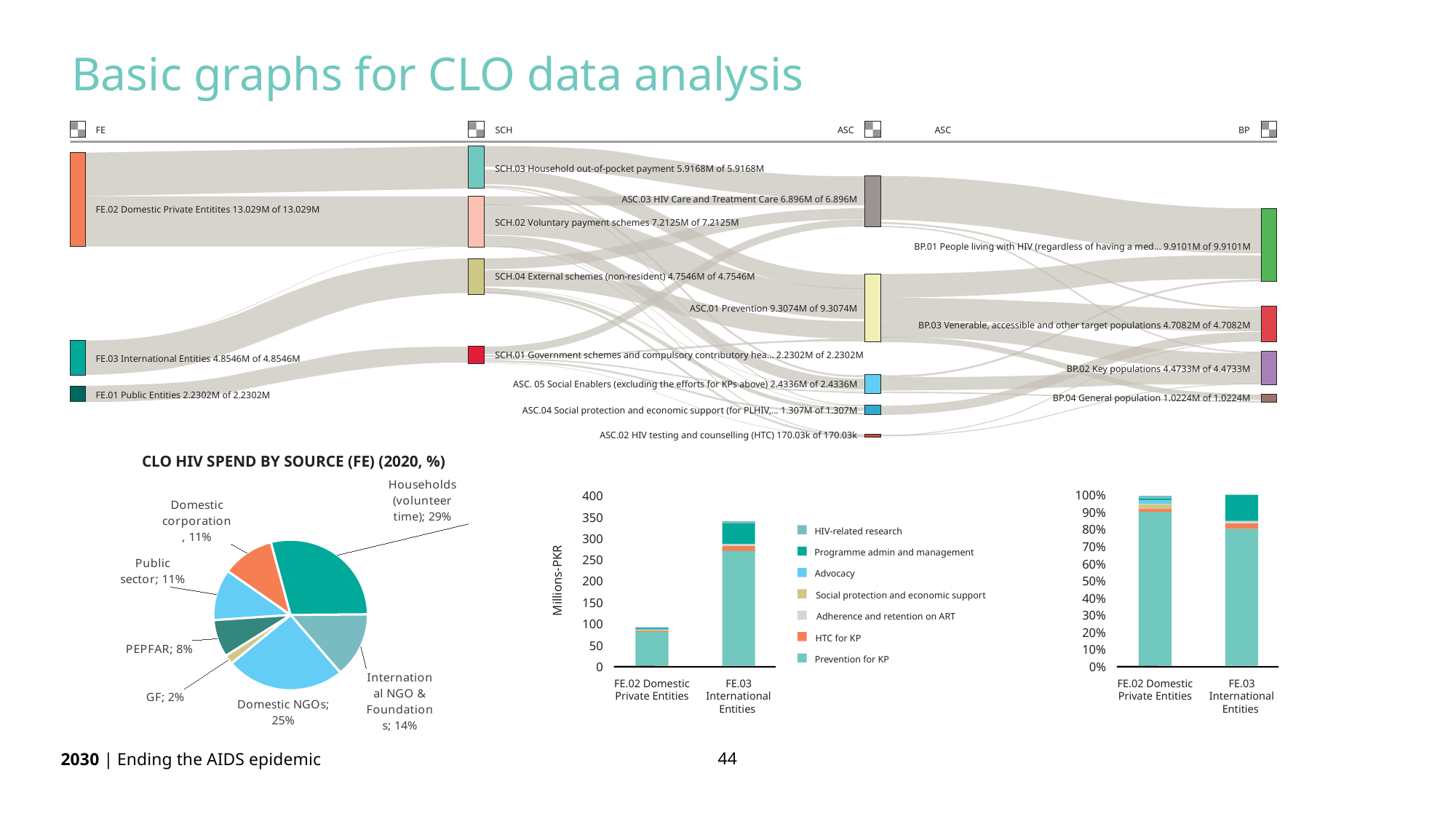
In the pie chart 'CLO HIV SPEND BY SOURCE (FE) (2020, %)', what share is attributed to Domestic NGOs? 25% In the middle stacked bar chart (Millions PKR), which category has the larger total, FE.02 Domestic Private Entities or FE.03 International Entities? FE.03 International Entities In the pie chart 'CLO HIV SPEND BY SOURCE (FE) (2020, %)', what is the difference between the Domestic NGOs share and the PEPFAR share? 17% In the pie chart 'CLO HIV SPEND BY SOURCE (FE) (2020, %)', what share is attributed to Households (volunteer time)? 29% In the pie chart 'CLO HIV SPEND BY SOURCE (FE) (2020, %)', which source has the largest share? Households (volunteer time) In the pie chart 'CLO HIV SPEND BY SOURCE (FE) (2020, %)', which source has the smallest share? GF In the flow diagram at the top of the slide, what value is shown for FE.02 Domestic Private Entitites? 13.029M What kind of chart is the chart at the bottom right of the slide? Bar chart (100% stacked) In the middle stacked bar chart (Millions PKR), how many series does the legend list? 7 In the middle stacked bar chart (Millions PKR), is the total for FE.03 International Entities greater or less than 300? greater In the middle stacked bar chart (Millions PKR), is the total for FE.02 Domestic Private Entities greater or less than 100? less How many slices does the pie chart 'CLO HIV SPEND BY SOURCE (FE) (2020, %)' have? 7